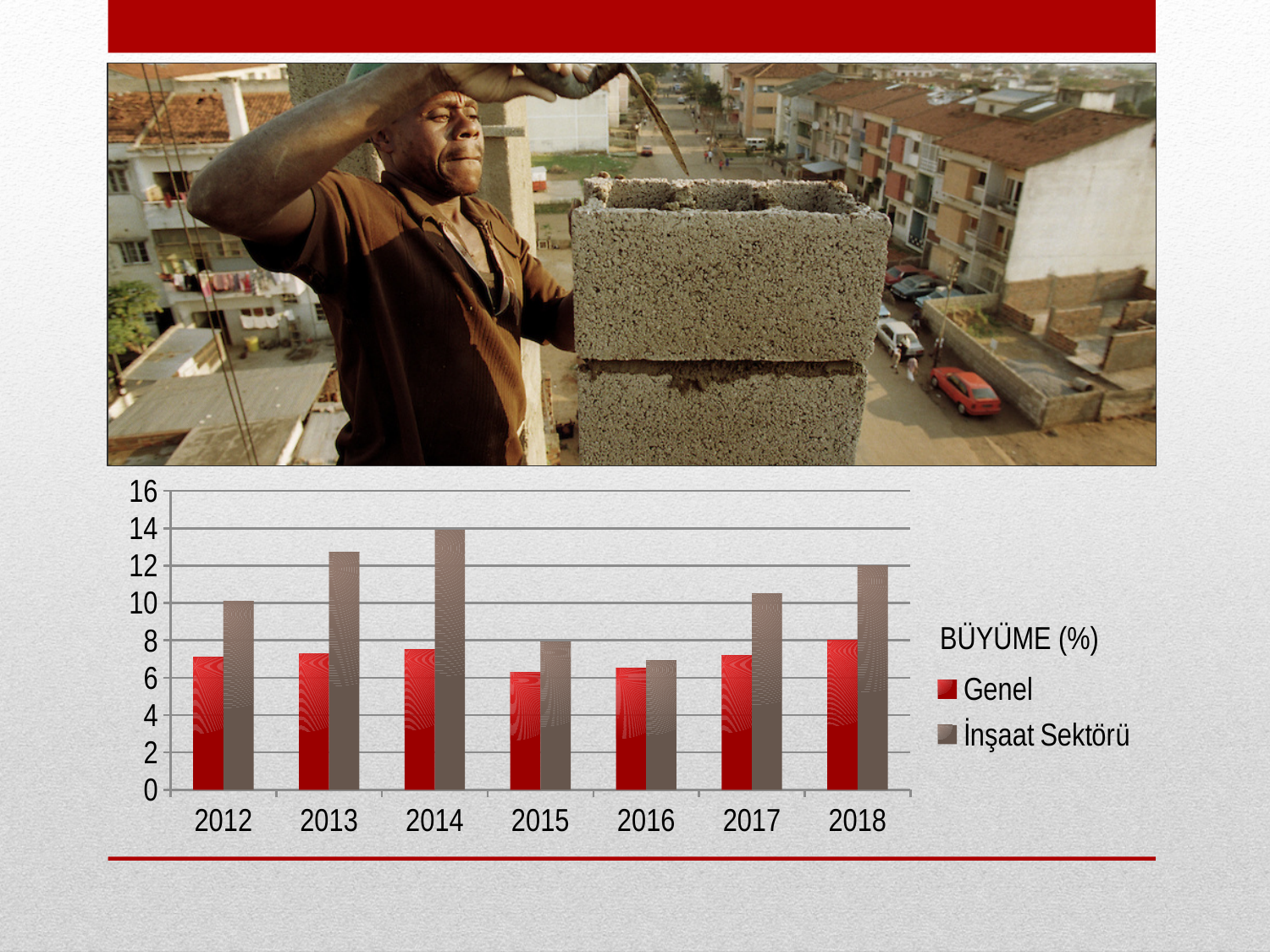
What is the title shown above the chart legend? BÜYÜME (%) Is the İnşaat Sektörü value for 2013 greater or less than 12? greater What kind of chart is shown on the slide? bar chart In which year is the İnşaat Sektörü value lowest? 2016 Does the İnşaat Sektörü value rise or fall from 2014 to 2016? fall How many series does the chart legend list? 2 Which is larger in 2014, the Genel value or the İnşaat Sektörü value? İnşaat Sektörü Is the Genel value for 2012 greater or less than 6? greater How many years are shown on the x axis of the chart? 7 In which year is the Genel value highest? 2018 In which year is the İnşaat Sektörü value highest? 2014